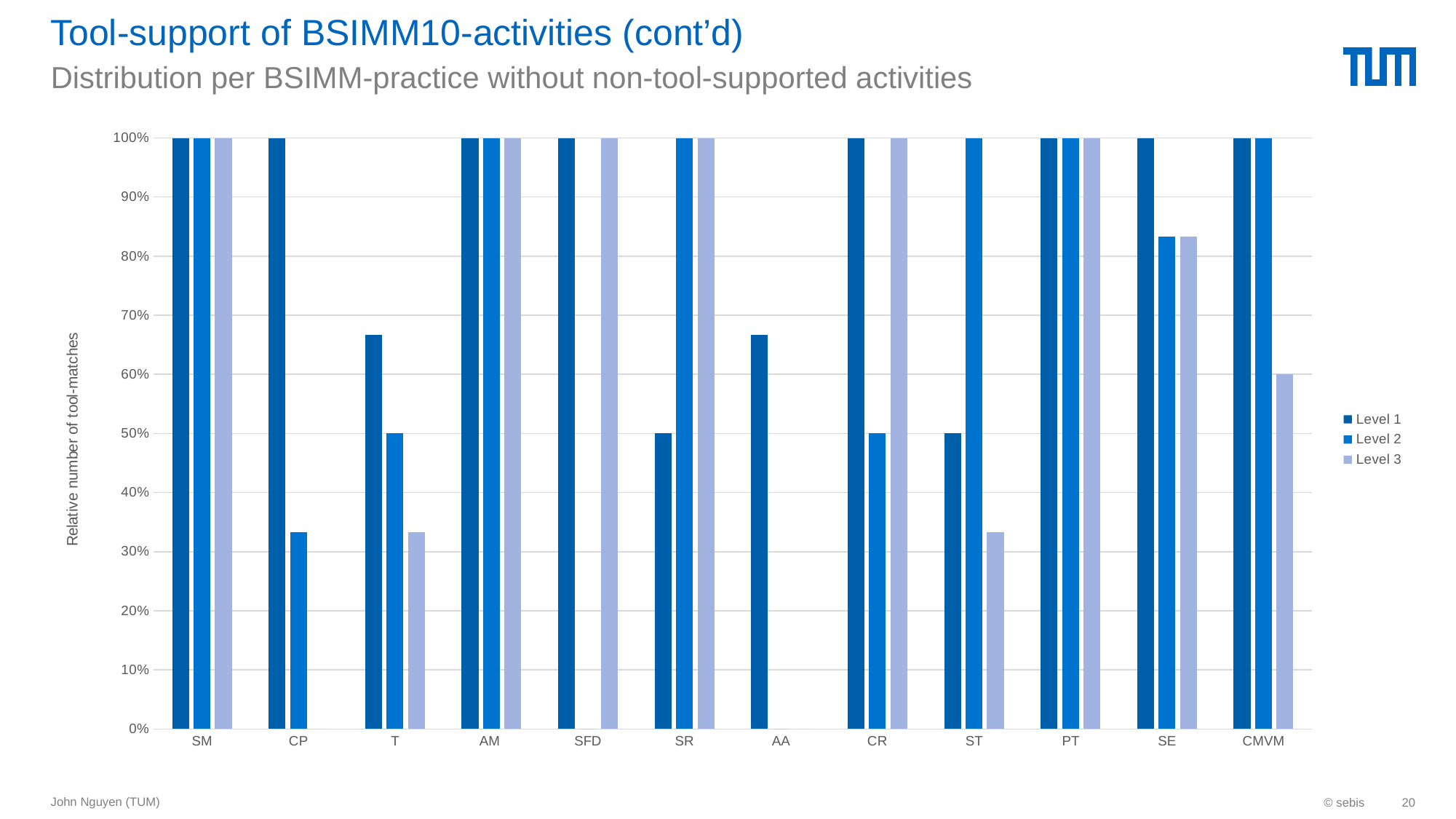
What is the label of the y axis? Relative number of tool-matches How many BSIMM-practice categories are shown on the x axis? 12 Is the Level 2 value for SE greater or less than 80%? greater Which is larger, the Level 3 value for CMVM or the Level 3 value for ST? CMVM What is the difference between the Level 3 value for CMVM and the Level 2 value for T? 10% What type of chart is shown on the slide? bar chart What is the Level 1 value for SR? 50% What is the Level 2 value for T? 50% Is the Level 1 value for AA greater or less than 60%? greater How many series does the legend list? 3 What is the Level 3 value for CMVM? 60% Is the Level 2 value for CP greater or less than 40%? less